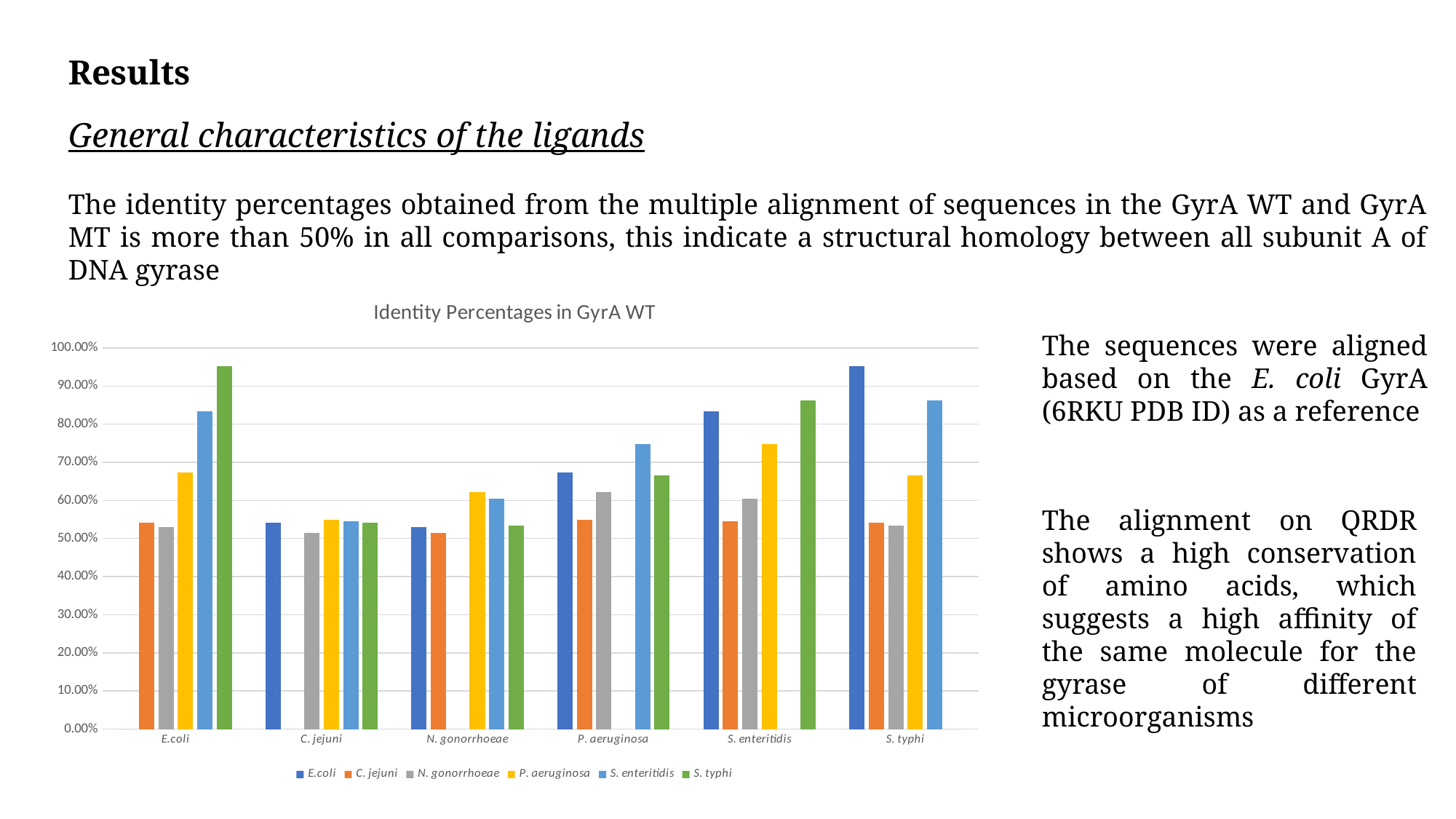
How many series does the chart legend list? 6 What colour represents the S. typhi series in the chart? green What kind of chart is shown on the slide? bar chart In the E.coli category, is the value for the S. typhi series greater or less than 90.00%? greater In the P. aeruginosa category, is the value for the S. enteritidis series greater or less than 70.00%? greater In the N. gonorrhoeae category, which is larger: the P. aeruginosa bar or the C. jejuni bar? P. aeruginosa In the S. enteritidis category, which series has the highest bar? S. typhi In the E.coli category, which series has the highest bar? S. typhi How many categories are shown along the x axis of the chart? 6 What is the title of the chart? Identity Percentages in GyrA WT In the C. jejuni category, is the value for the N. gonorrhoeae series greater or less than 60.00%? less In the P. aeruginosa category, which series has the lowest bar? C. jejuni